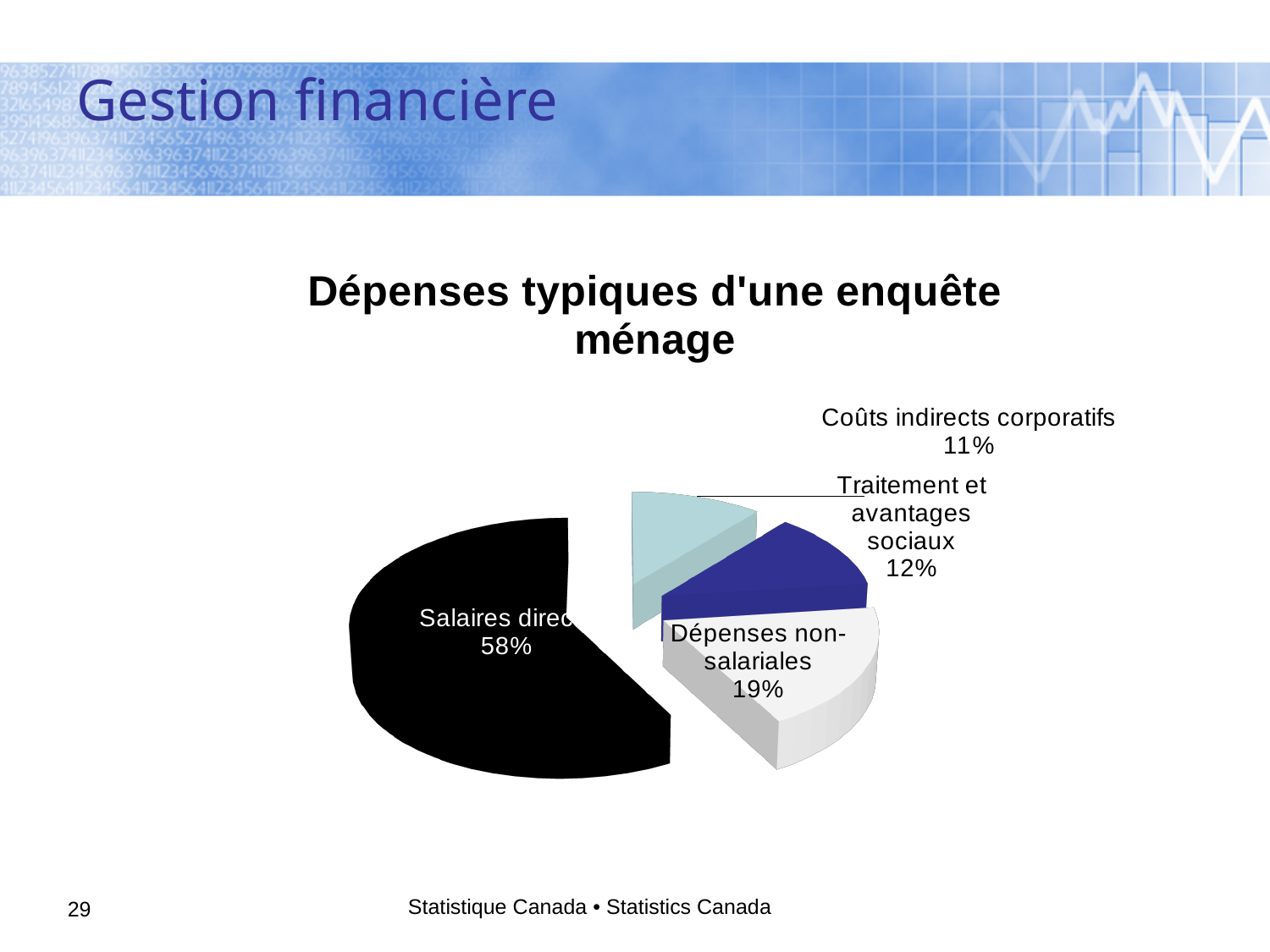
What is the title of the chart? Dépenses typiques d'une enquête ménage How many slices does the pie chart have? 4 What share of the pie is Coûts indirects corporatifs? 11% What share of the pie is Salaires directs? 58% Which is larger, Dépenses non-salariales or Traitement et avantages sociaux? Dépenses non-salariales What share of the pie is Traitement et avantages sociaux? 12% Which category has the smallest share of the pie? Coûts indirects corporatifs What kind of chart is shown on the slide? Pie chart Which category has the largest share of the pie? Salaires directs What is the difference in percentage points between Salaires directs and Dépenses non-salariales? 39 What colour is the Salaires directs slice? Black